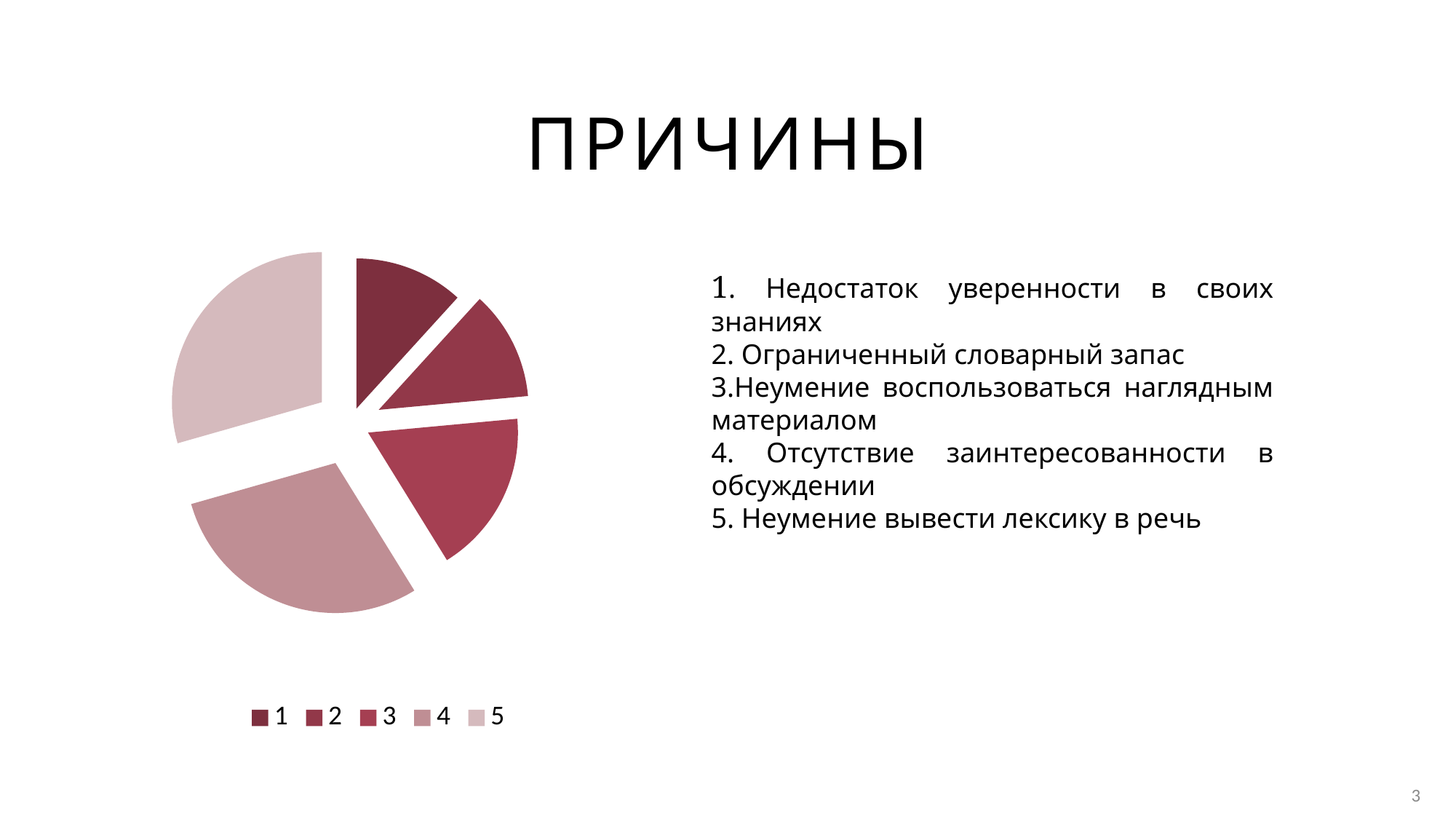
What is the title of the slide containing the pie chart? ПРИЧИНЫ Which legend entry of the pie chart is shown in the lightest colour? 5 How many entries does the legend of the pie chart list? 5 What kind of chart is shown on the slide? pie chart Which slice of the pie chart is larger, slice 3 or slice 1? 3 Which slice of the pie chart is larger, slice 5 or slice 2? 5 How many slices does the pie chart have? 5 Which slice of the pie chart is larger, slice 5 or slice 1? 5